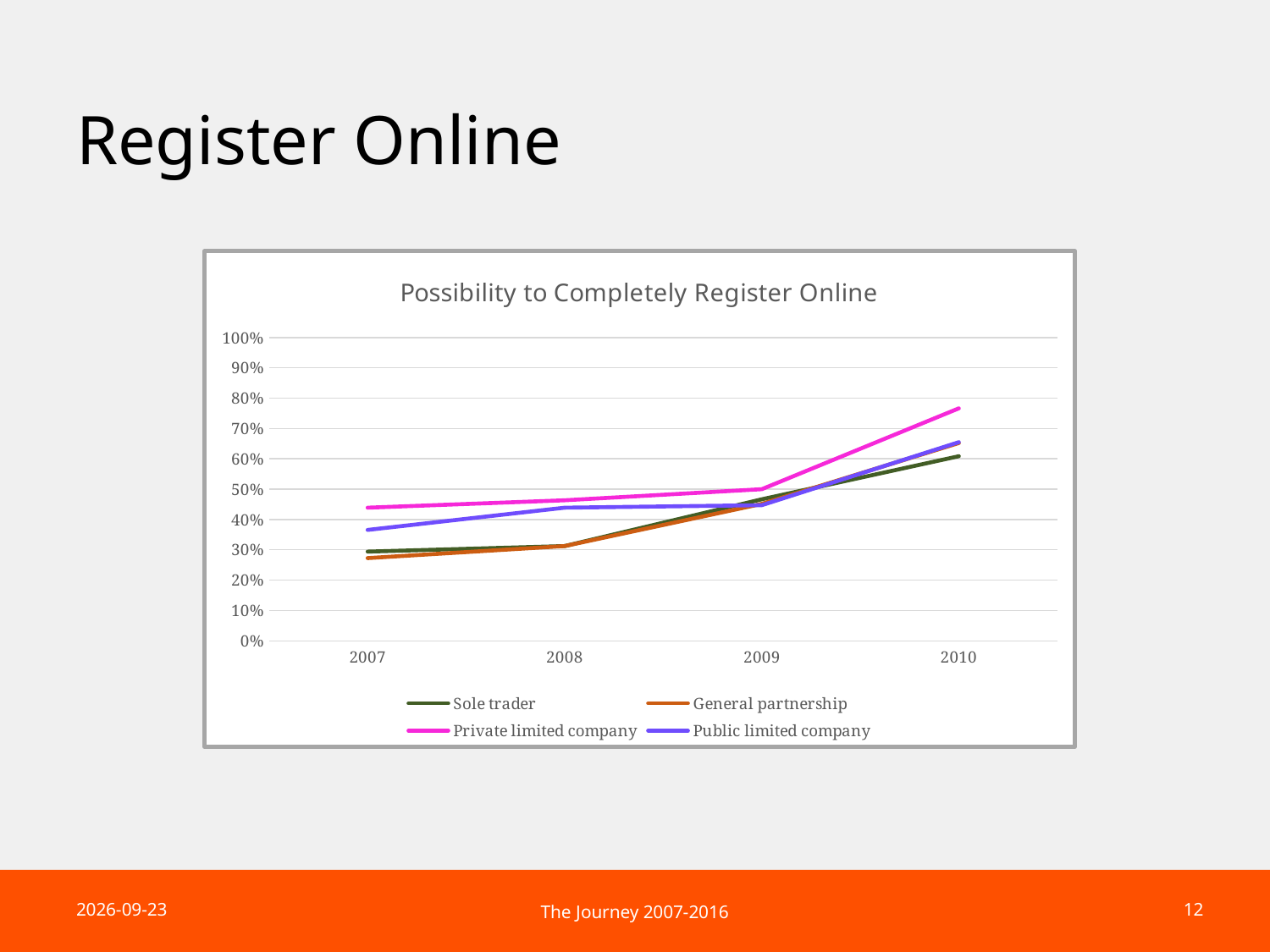
Does the Private limited company line rise or fall from 2007 to 2010? rise How many years are shown on the x axis? 4 Which series has the highest value in 2007? Private limited company What kind of chart is shown on the slide? line chart Is the value for Public limited company in 2007 greater or less than 40%? less What is the title of the chart? Possibility to Completely Register Online Is the value for Private limited company in 2010 greater or less than 70%? greater Which series has the highest value in 2010? Private limited company Which is larger in 2007, the value for Private limited company or the value for Sole trader? Private limited company How many series does the legend list? 4 Is the value for Sole trader in 2010 greater or less than 50%? greater